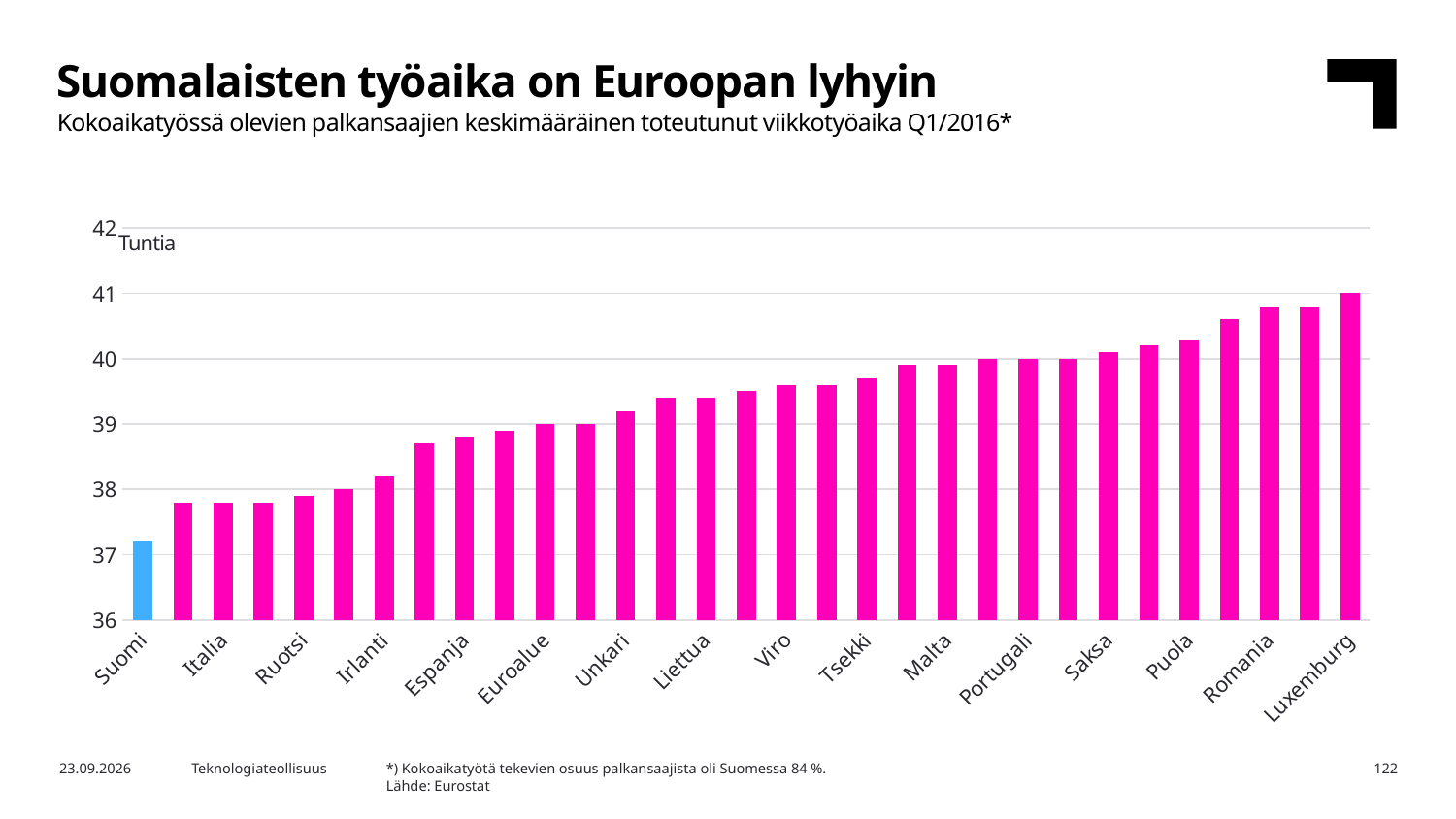
Is the value for Luxemburg greater or less than 40? greater Is the value for Unkari greater or less than 39? greater What unit label is shown at the top of the y axis? Tuntia What kind of chart is shown on the slide? bar chart Is the value for Suomi greater or less than 38? less Which country has the lowest bar in the chart? Suomi Do the bar values rise or fall from left to right along the x axis? rise Which has a larger value, Italia or Puola? Puola Which has a larger value, Suomi or Luxemburg? Luxemburg Which country has the highest bar in the chart? Luxemburg